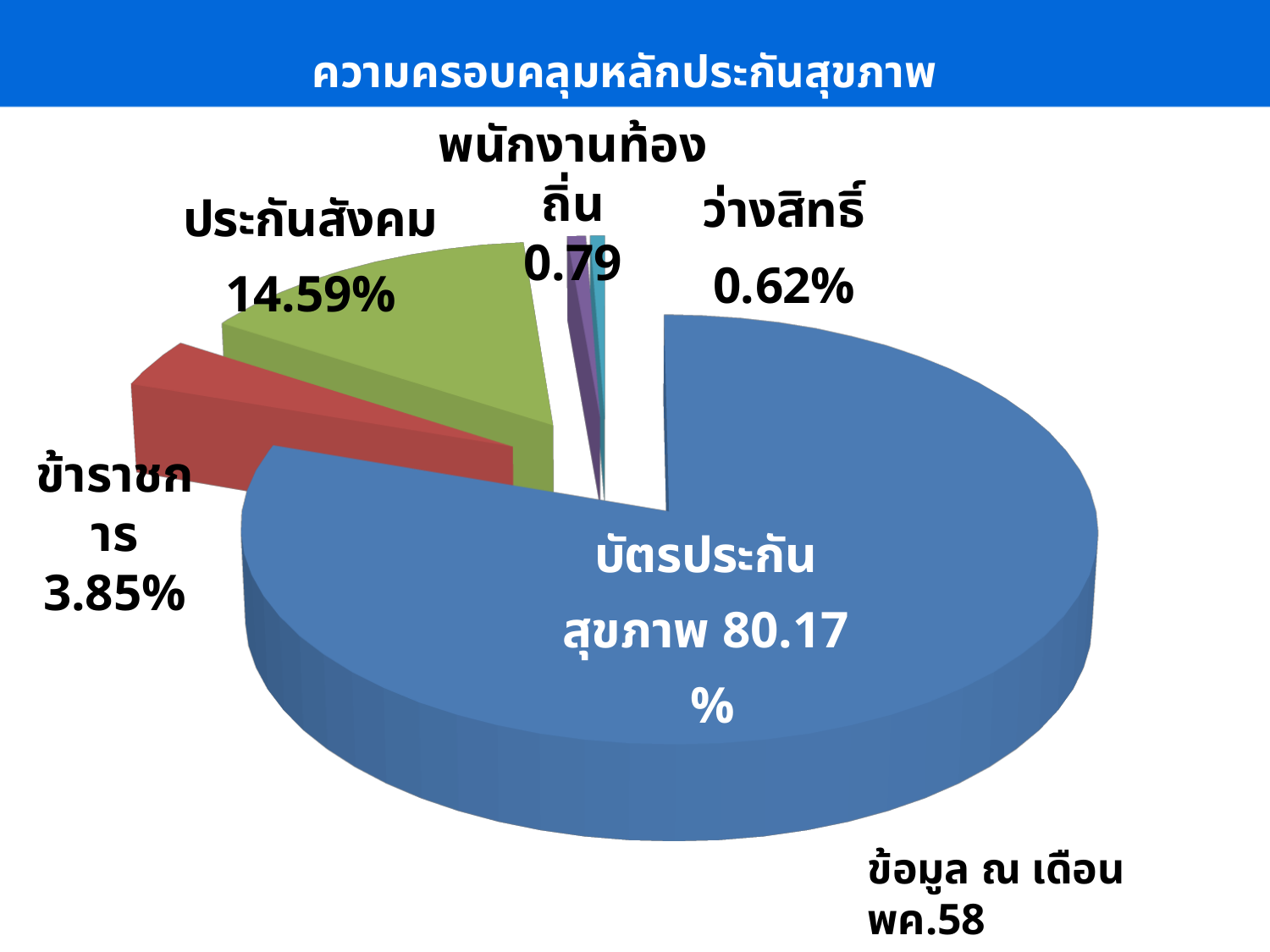
What value is printed for พนักงานท้องถิ่น? 0.79 What type of chart is shown on the slide? Pie chart What is the value shown for ประกันสังคม? 14.59% What percentage does the บัตรประกันสุขภาพ slice represent? 80.17% How many slices does the pie chart have? 5 What is the difference in percentage points between บัตรประกันสุขภาพ and ประกันสังคม? 65.58 Which category has the largest share of the pie? บัตรประกันสุขภาพ Which category has the smallest share of the pie? ว่างสิทธิ์ What is the value shown for ว่างสิทธิ์? 0.62% What is the difference in percentage points between ประกันสังคม and ข้าราชการ? 10.74 Which is larger, ข้าราชการ or ว่างสิทธิ์? ข้าราชการ What is the value shown for ข้าราชการ? 3.85%